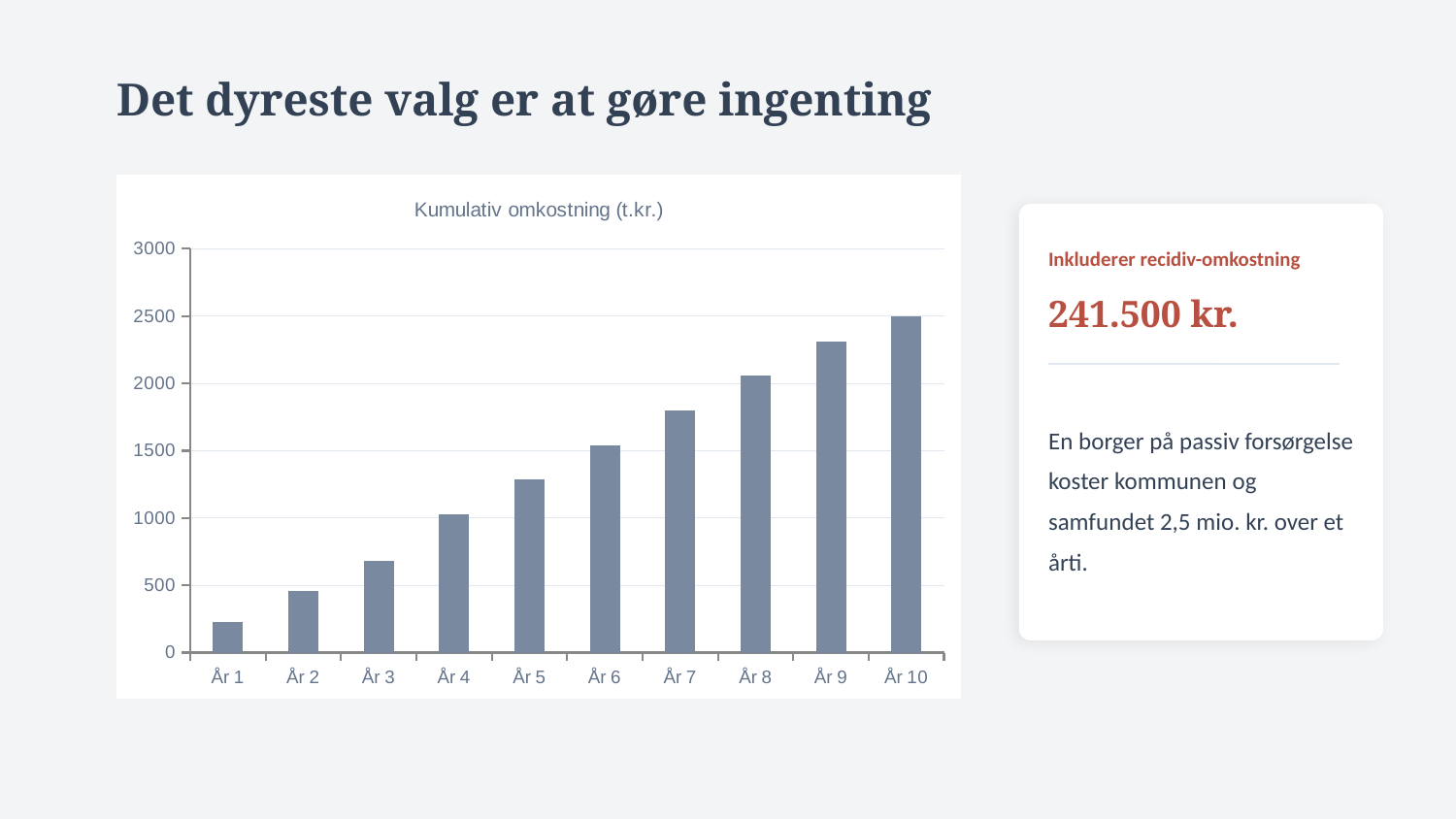
How many categories (years) are shown on the x axis of the chart? 10 Is the value for År 8 greater or less than 2000? greater Is the value for År 1 greater or less than 500? less Which year has the lowest cumulative cost in the chart? År 1 Is the value for År 5 greater or less than 1500? less Which year has the highest cumulative cost in the chart? År 10 What type of chart is shown on the slide? bar chart Do the values in the chart rise or fall from År 1 to År 10? rise Which is larger in the chart, the value for År 3 or the value for År 6? År 6 What is the title of the chart? Kumulativ omkostning (t.kr.)